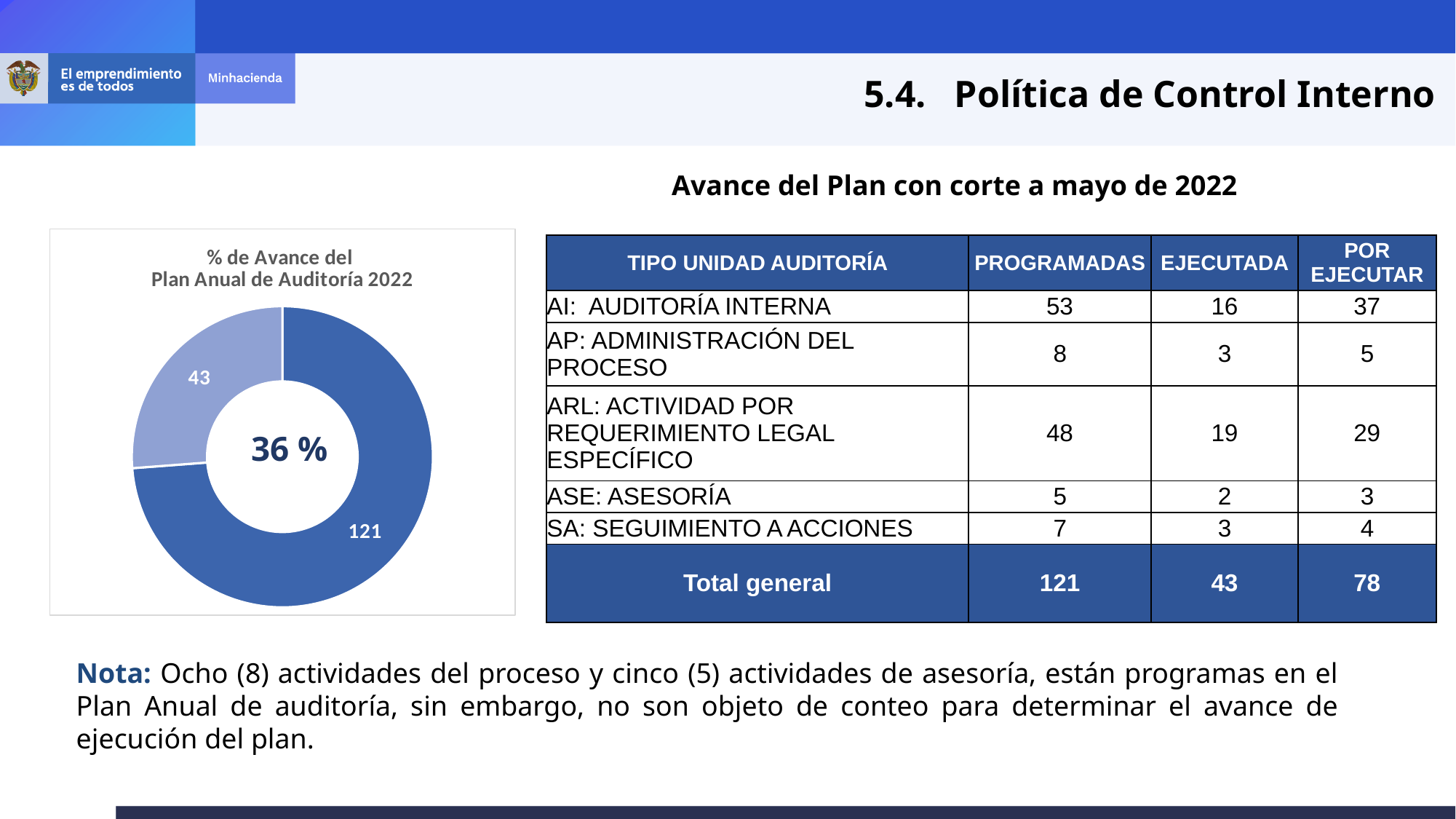
What is the difference between the two slice values on the doughnut chart, 121 and 43? 78 What is the smallest value shown on the doughnut chart? 43 What value is labelled on the larger, dark blue slice of the doughnut chart? 121 What value is labelled on the smaller, light blue slice of the doughnut chart? 43 Is the value of the dark blue slice on the doughnut chart greater or less than 100? greater How many slices does the doughnut chart have? 2 What is the largest value shown on the doughnut chart? 121 What percentage is printed in the centre of the doughnut chart? 36 % What kind of chart is shown on the left of the slide? doughnut chart What is the title of the chart on the left of the slide? % de Avance del Plan Anual de Auditoría 2022 Which slice of the doughnut chart is larger, the one labelled 43 or the one labelled 121? 121